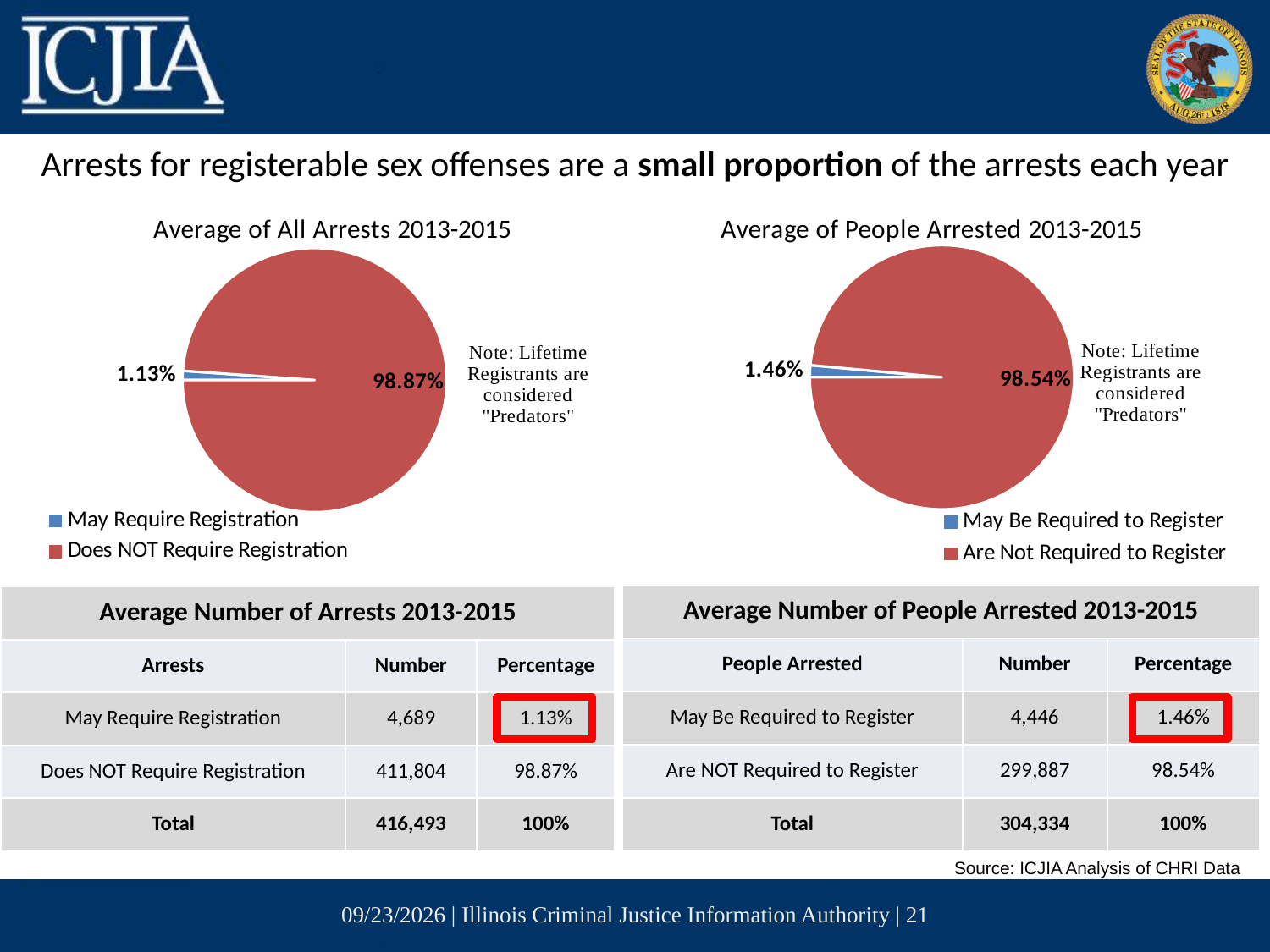
Which is larger: the 'May Require Registration' share in the 'Average of All Arrests 2013-2015' chart or the 'May Be Required to Register' share in the 'Average of People Arrested 2013-2015' chart? May Be Required to Register (1.46%) In the 'Average of People Arrested 2013-2015' chart, which slice is the largest? Are Not Required to Register In the 'Average of People Arrested 2013-2015' chart, what colour is the 'May Be Required to Register' slice? Blue How many entries does the legend of the 'Average of All Arrests 2013-2015' chart list? 2 In the 'Average of All Arrests 2013-2015' chart, what is the difference in percentage points between 'Does NOT Require Registration' and 'May Require Registration'? 97.74 In the 'Average of People Arrested 2013-2015' chart, what percentage is shown for 'May Be Required to Register'? 1.46% In the 'Average of People Arrested 2013-2015' chart, what percentage is shown for 'Are Not Required to Register'? 98.54% In the 'Average of All Arrests 2013-2015' chart, which slice is the smallest? May Require Registration What type of chart is 'Average of All Arrests 2013-2015'? Pie chart In the 'Average of All Arrests 2013-2015' chart, what percentage is shown for 'Does NOT Require Registration'? 98.87% How many slices does the 'Average of People Arrested 2013-2015' pie chart have? 2 In the 'Average of All Arrests 2013-2015' chart, what percentage is shown for 'May Require Registration'? 1.13%